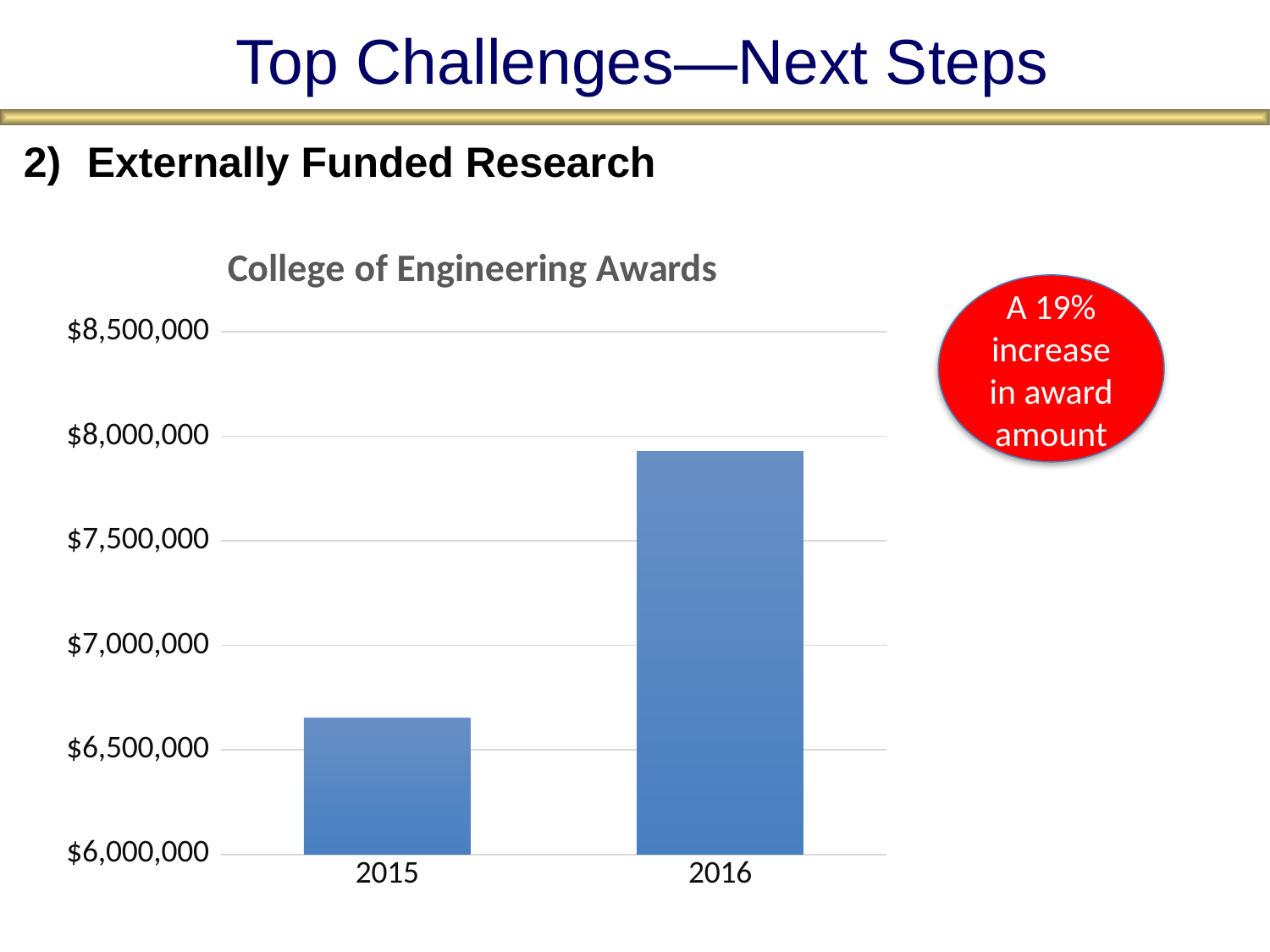
Is the value for 2016 greater or less than $7,500,000? greater Do the award amounts rise or fall from 2015 to 2016? rise Is the value for 2015 greater or less than $6,500,000? greater Is the value for 2016 greater or less than $8,000,000? less Which year has the highest award amount? 2016 How many years are plotted in the chart? 2 Which year has the larger award amount, 2015 or 2016? 2016 What is the title of the chart? College of Engineering Awards What kind of chart is shown on the slide? bar chart Which year has the lowest award amount? 2015 According to the red callout next to the chart, what is the percentage increase in award amount? 19%